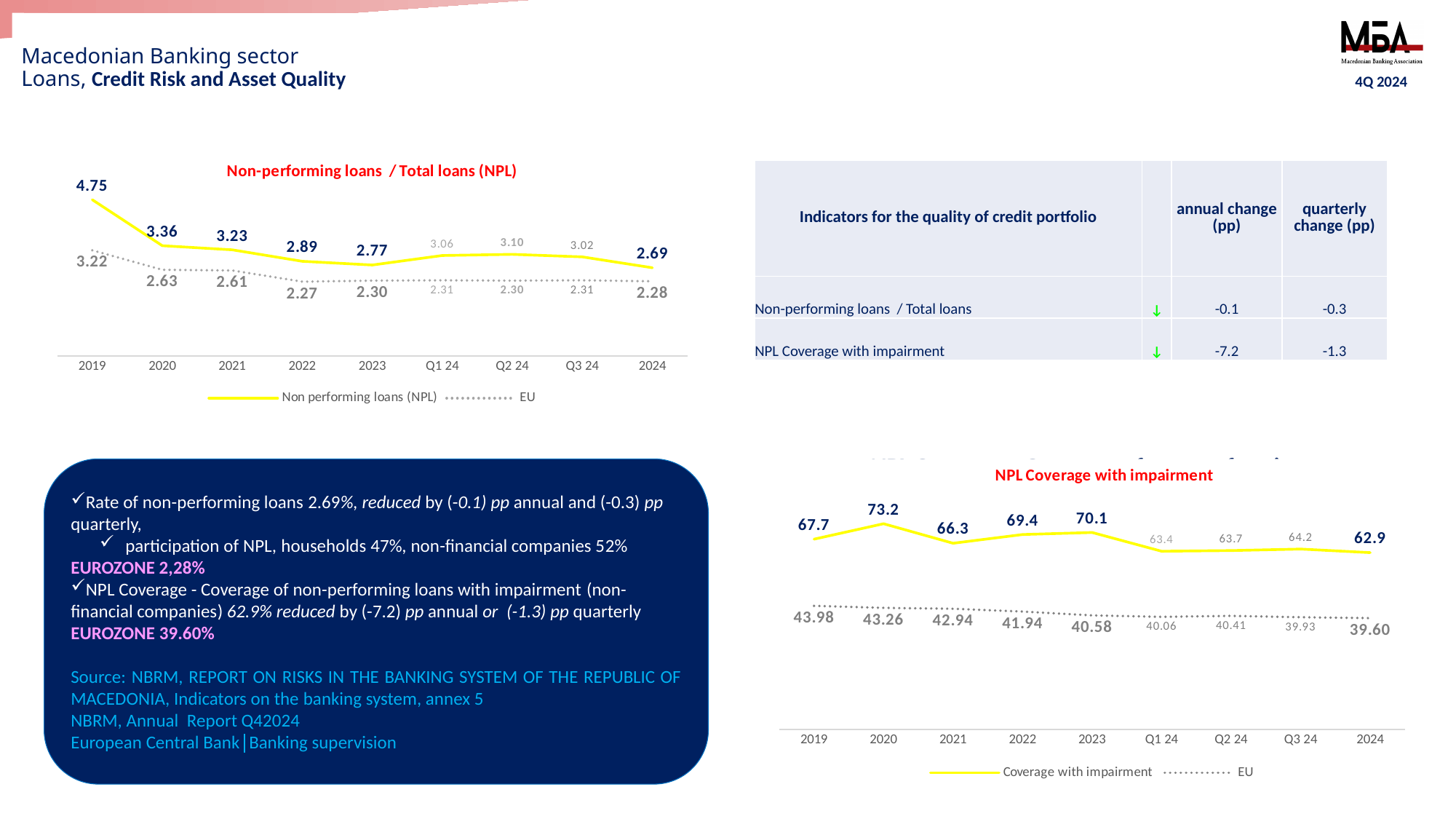
In the 'Non-performing loans / Total loans (NPL)' chart, does the Non performing loans (NPL) series generally rise or fall from 2019 to 2024? fall In the 'Non-performing loans / Total loans (NPL)' chart, what is the difference between the NPL value and the EU value in 2024? 0.41 In the 'Non-performing loans / Total loans (NPL)' chart, what is the Non performing loans (NPL) value for 2019? 4.75 In the 'NPL Coverage with impairment' chart, how many periods are shown on the x axis? 9 In the 'NPL Coverage with impairment' chart, which is larger in 2023: the Coverage with impairment value or the EU value? Coverage with impairment In the 'NPL Coverage with impairment' chart, which period has the lowest Coverage with impairment value? 2024 In the 'Non-performing loans / Total loans (NPL)' chart, what is the EU value for 2024? 2.28 In the 'NPL Coverage with impairment' chart, what is the EU value for 2024? 39.60 What kind of chart is the 'NPL Coverage with impairment' chart? line chart In the 'Non-performing loans / Total loans (NPL)' chart, how many series does the legend list? 2 In the 'NPL Coverage with impairment' chart, what is the Coverage with impairment value for 2020? 73.2 In the 'Non-performing loans / Total loans (NPL)' chart, which period has the highest Non performing loans (NPL) value? 2019